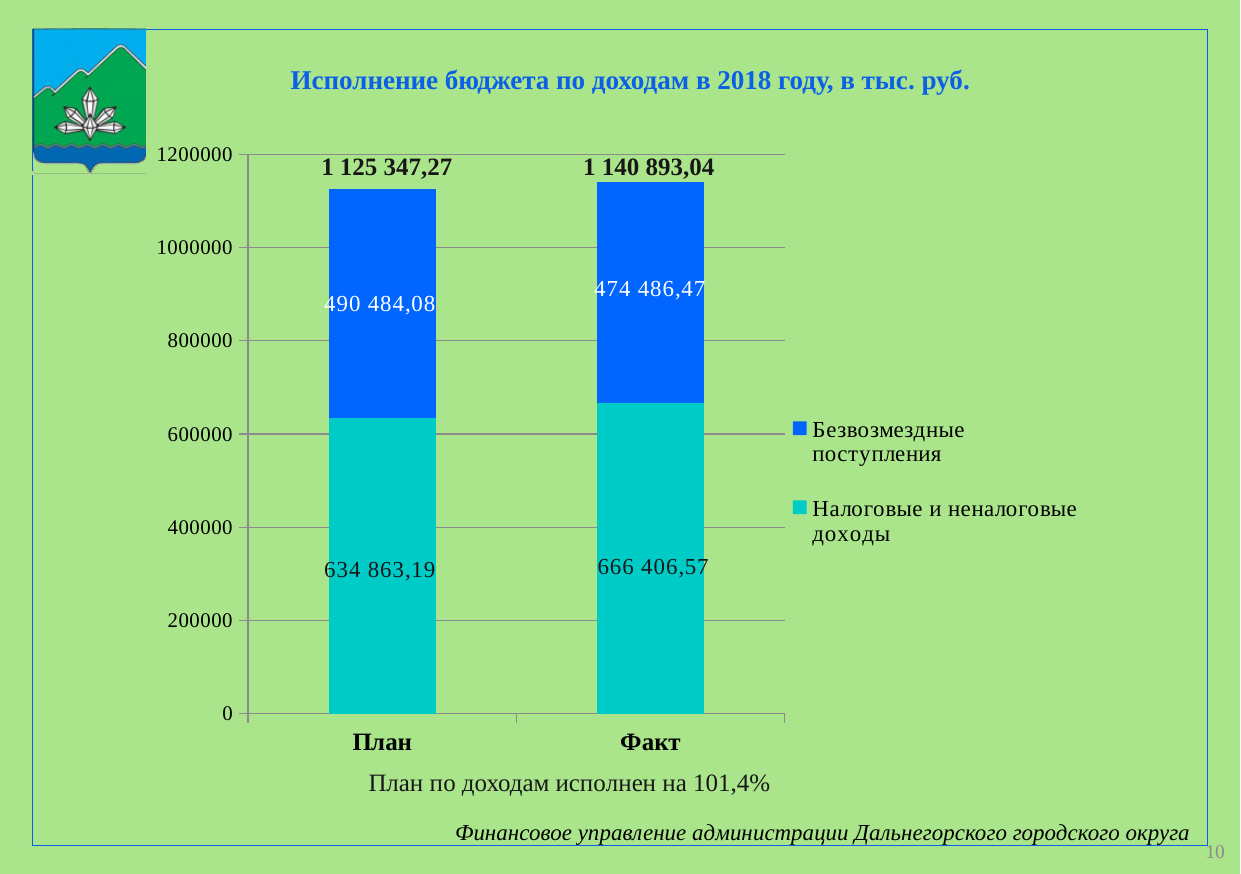
What is the total of the stacked bar for План? 1 125 347,27 Is the Налоговые и неналоговые доходы value for Факт greater or less than 600000? greater What is the value of Безвозмездные поступления for Факт? 474 486,47 How many series does the legend list? 2 What is the difference between the Безвозмездные поступления values for План and Факт? 15 997,61 What is the total of the stacked bar for Факт? 1 140 893,04 What type of chart is shown on the slide? Stacked bar chart What is the difference between the Налоговые и неналоговые доходы values for Факт and План? 31 543,38 Which category has the higher total, План or Факт? Факт What is the value of Налоговые и неналоговые доходы for План? 634 863,19 What is the value of Безвозмездные поступления for План? 490 484,08 How many categories are shown on the x axis? 2